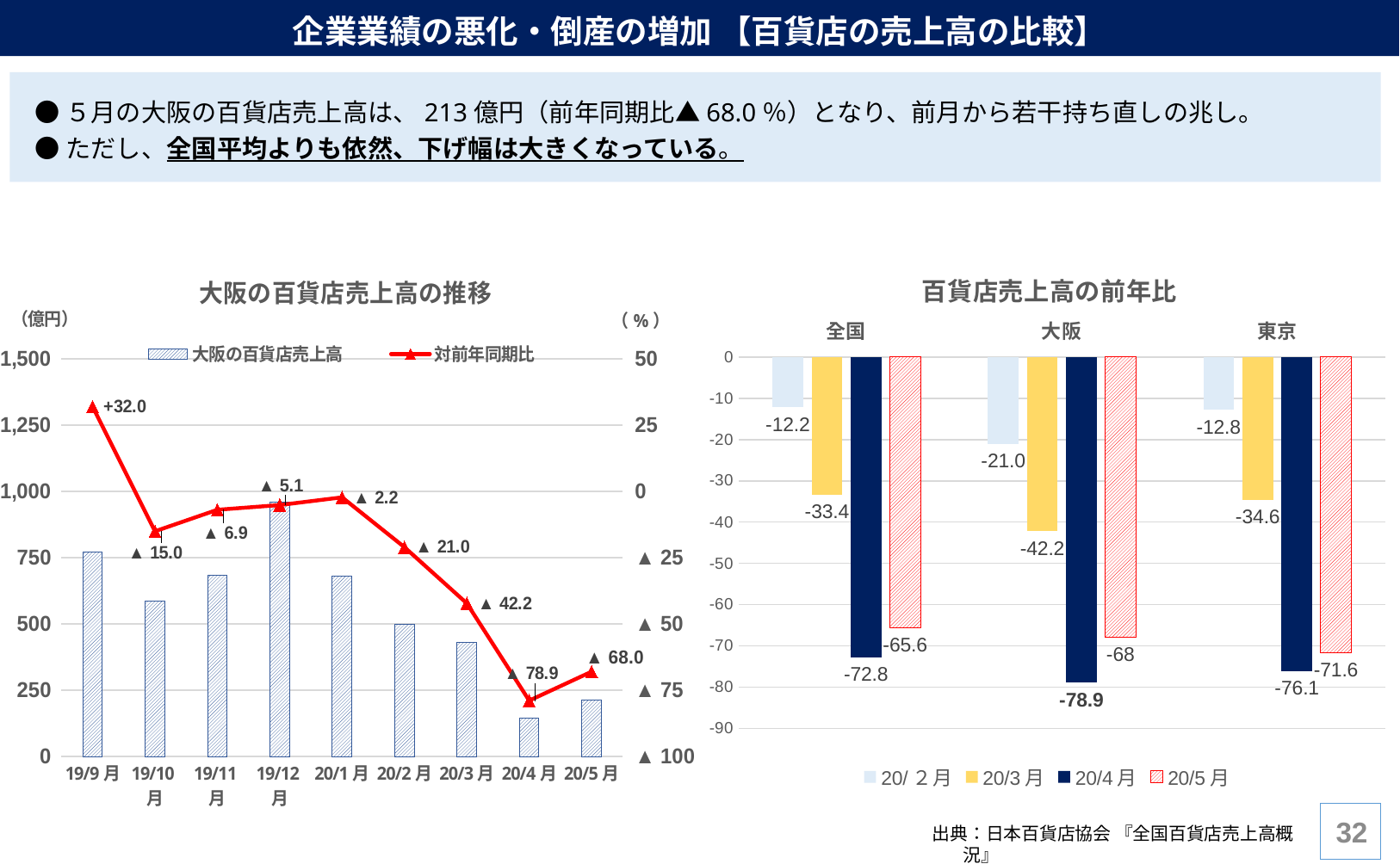
In the chart titled 百貨店売上高の前年比, which category has the lowest value in the 20/4月 series? 大阪 In the chart titled 大阪の百貨店売上高の推移, what is the 対前年同期比 value for 19/9月? +32.0 In the chart titled 百貨店売上高の前年比, what is the difference between the 20/2月 values for 大阪 and 全国? 8.8 In the chart titled 百貨店売上高の前年比, which is larger, the 20/5月 value for 全国 or for 東京? 全国 In the chart titled 百貨店売上高の前年比, how many categories are shown on the x axis? 3 In the chart titled 百貨店売上高の前年比, how many series does the legend list? 4 In the chart titled 大阪の百貨店売上高の推移, what is the 対前年同期比 value for 20/5月? ▲ 68.0 In the chart titled 百貨店売上高の前年比, what is the value for 大阪 in the 20/4月 series? -78.9 In the chart titled 百貨店売上高の前年比, what is the value for 東京 in the 20/3月 series? -34.6 In the chart titled 大阪の百貨店売上高の推移, is the 大阪の百貨店売上高 bar for 19/12月 greater or less than 750? greater In the chart titled 百貨店売上高の前年比, what is the value for 全国 in the 20/5月 series? -65.6 In the chart titled 大阪の百貨店売上高の推移, how many months are shown on the x axis? 9